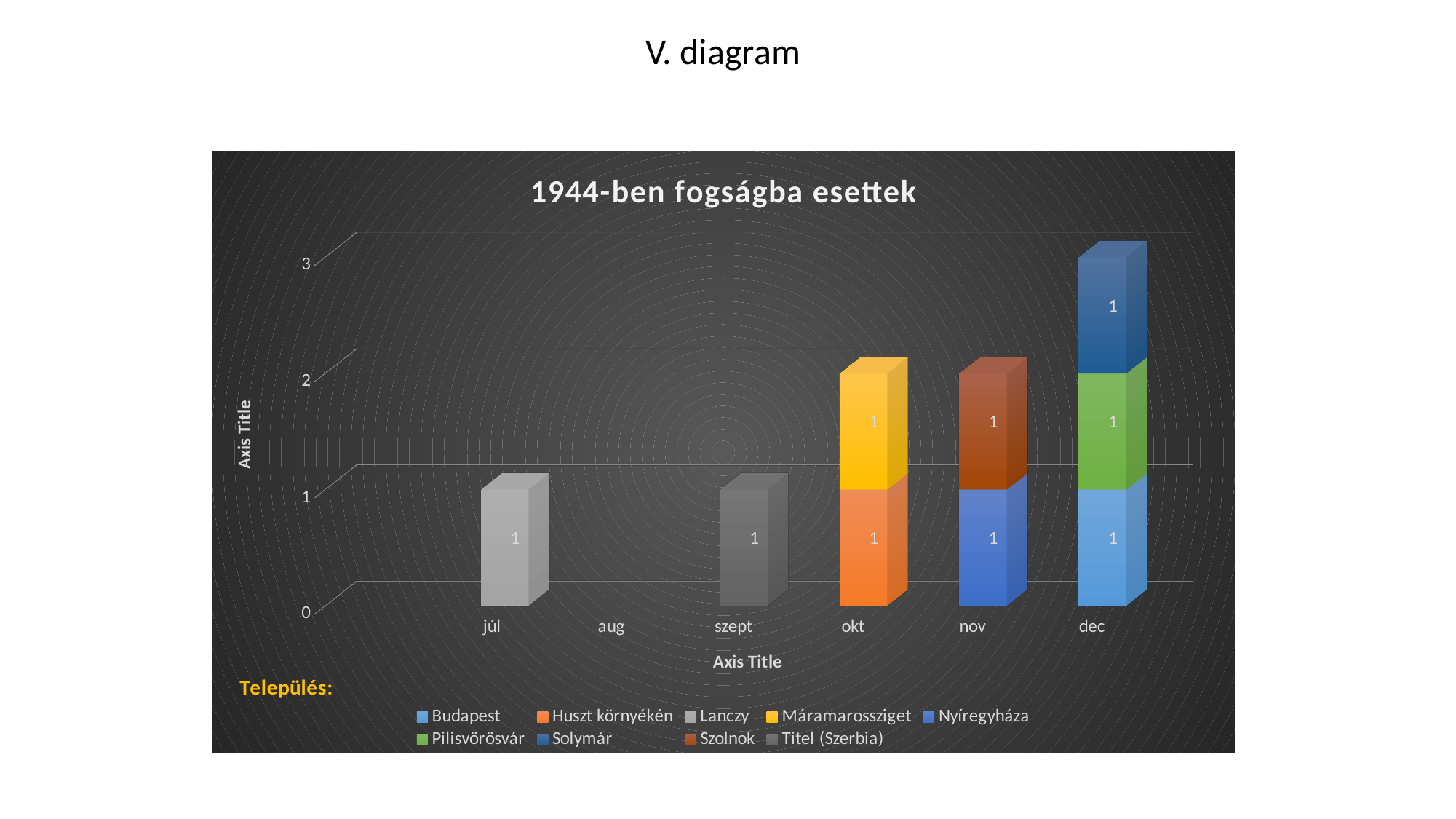
What kind of chart is shown on the slide? stacked bar chart What is the value for Máramarossziget in okt? 1 What is the title of the chart? 1944-ben fogságba esettek What is the value for Lanczy in júl? 1 What is the total of the stacked bar for okt? 2 Which month has the highest stacked total? dec What is the difference between the stacked totals for dec and nov? 1 What is the value for Solymár in dec? 1 How many categories are shown on the x axis? 6 Which month has no bar at all? aug How many series does the legend list? 9 What is the total of the stacked bar for dec? 3